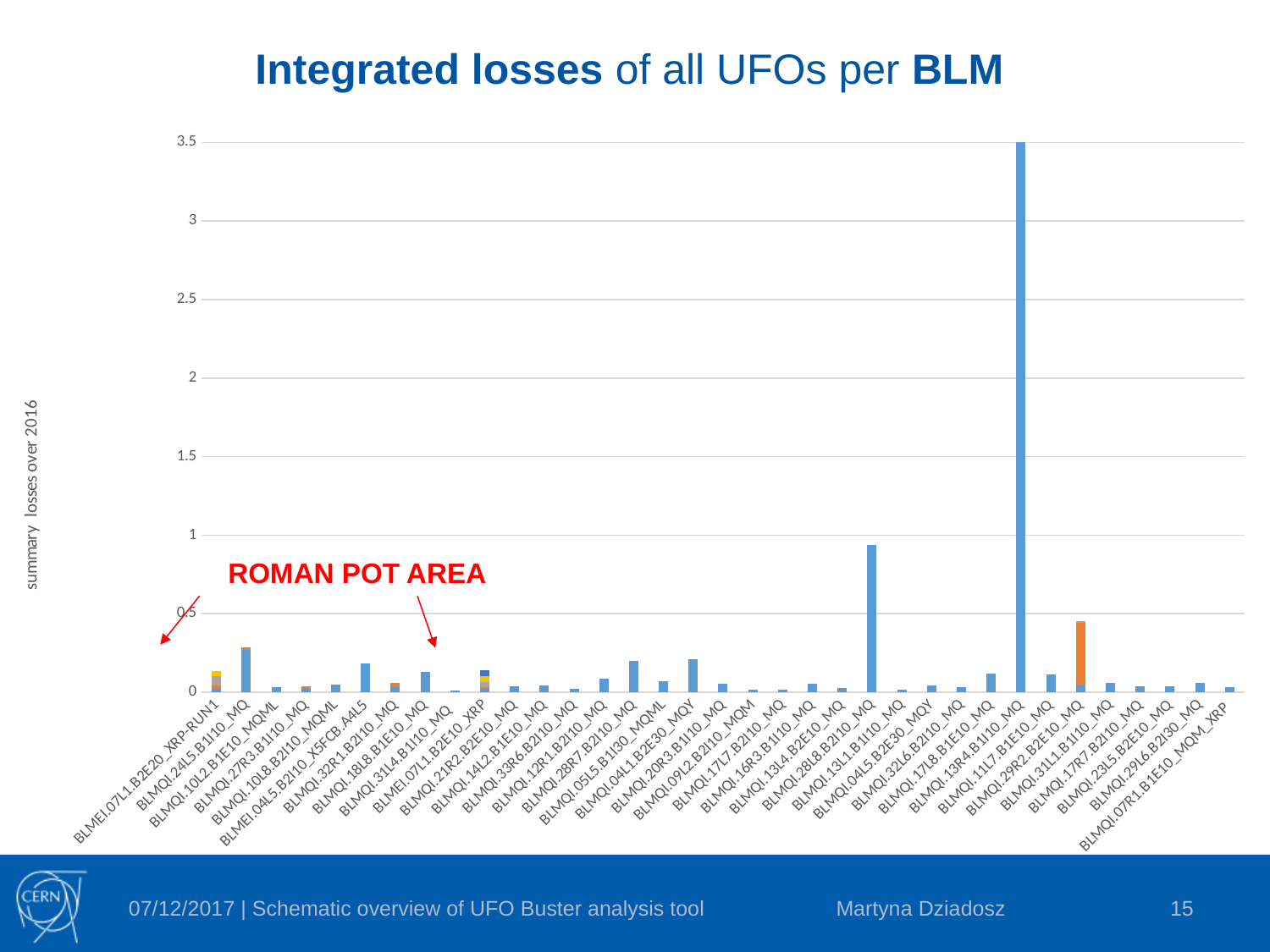
Is the value for BLMQI.28L8.B2I10_MQ greater or less than 1? less Which is larger, the value for BLMQI.13R4.B1I10_MQ or the value for BLMQI.28L8.B2I10_MQ? BLMQI.13R4.B1I10_MQ What is the title of the chart? Integrated losses of all UFOs per BLM Is the value for BLMQI.13R4.B1I10_MQ greater or less than 3? greater Is the value for BLMQI.29R2.B2E10_MQ greater or less than 0.5? less Which is larger, the value for BLMQI.28L8.B2I10_MQ or the value for BLMQI.24L5.B1I10_MQ? BLMQI.28L8.B2I10_MQ How many BLM categories are plotted along the x axis? 35 What kind of chart is shown on the slide? bar chart What is the highest value shown on the vertical axis? 3.5 Which BLM has the highest integrated loss in the chart? BLMQI.13R4.B1I10_MQ